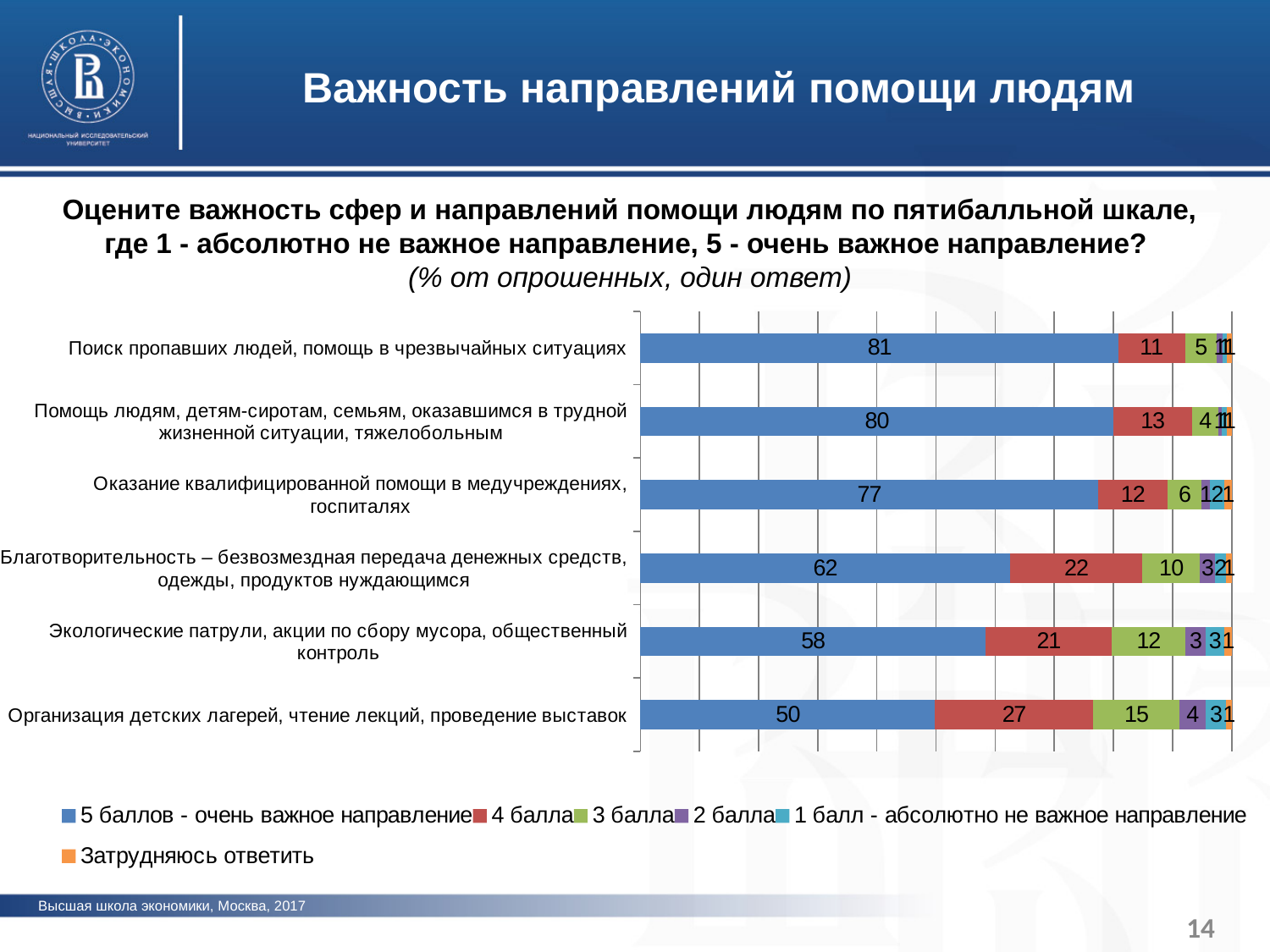
How many series does the legend list? 6 What is the difference in the "5 баллов" value between "Поиск пропавших людей, помощь в чрезвычайных ситуациях" and "Организация детских лагерей, чтение лекций, проведение выставок"? 31 Which category has the lowest share of "5 баллов - очень важное направление"? Организация детских лагерей, чтение лекций, проведение выставок Which category has the highest share of "5 баллов - очень важное направление"? Поиск пропавших людей, помощь в чрезвычайных ситуациях What colour represents "5 баллов - очень важное направление" in the chart? Blue What is the value of "4 балла" for "Организация детских лагерей, чтение лекций, проведение выставок"? 27 Which has a larger "3 балла" value: "Благотворительность – безвозмездная передача денежных средств, одежды, продуктов нуждающимся" or "Организация детских лагерей, чтение лекций, проведение выставок"? Организация детских лагерей, чтение лекций, проведение выставок What is the value of "3 балла" for "Экологические патрули, акции по сбору мусора, общественный контроль"? 12 What is the value of "4 балла" for "Помощь людям, детям-сиротам, семьям, оказавшимся в трудной жизненной ситуации, тяжелобольным"? 13 What type of chart is shown on the slide? Stacked bar chart How many categories (directions of help) are shown in the chart? 6 What percentage rated "Поиск пропавших людей, помощь в чрезвычайных ситуациях" as "5 баллов - очень важное направление"? 81